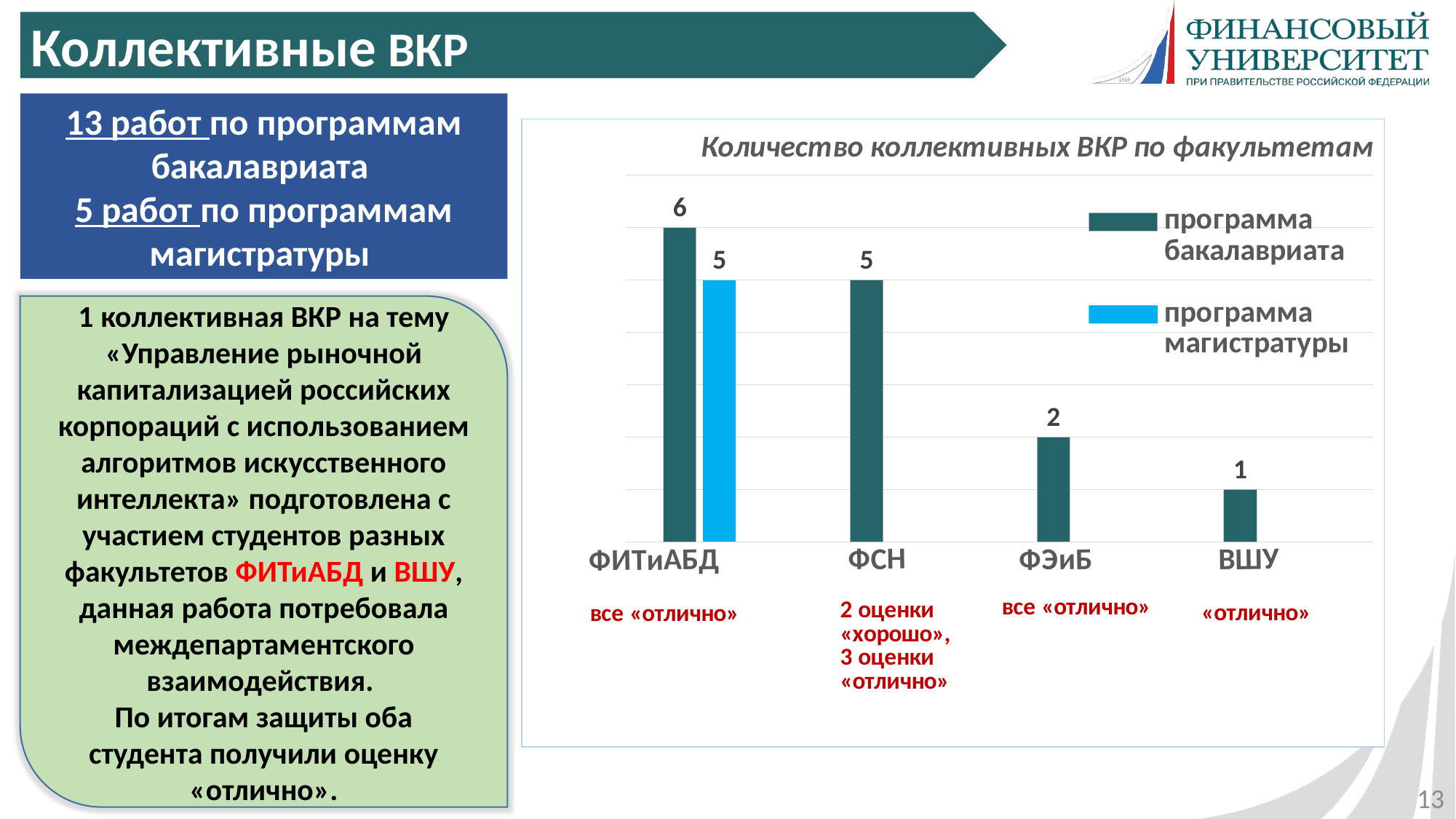
What is the value for ВШУ in the программа бакалавриата series? 1 What kind of chart is shown? bar chart What is the value for ФИТиАБД in the программа магистратуры series? 5 Which is larger: the программа бакалавриата value for ФСН or for ВШУ? ФСН How many faculties are shown on the x axis? 4 Which faculty has the lowest value in the программа бакалавриата series? ВШУ What is the value for ФЭиБ in the программа бакалавриата series? 2 What is the difference between the программа бакалавриата values for ФИТиАБД and ФЭиБ? 4 What is the value for ФИТиАБД in the программа бакалавриата series? 6 How many series does the legend list? 2 What is the value for ФСН in the программа бакалавриата series? 5 Which faculty has the highest value in the программа бакалавриата series? ФИТиАБД